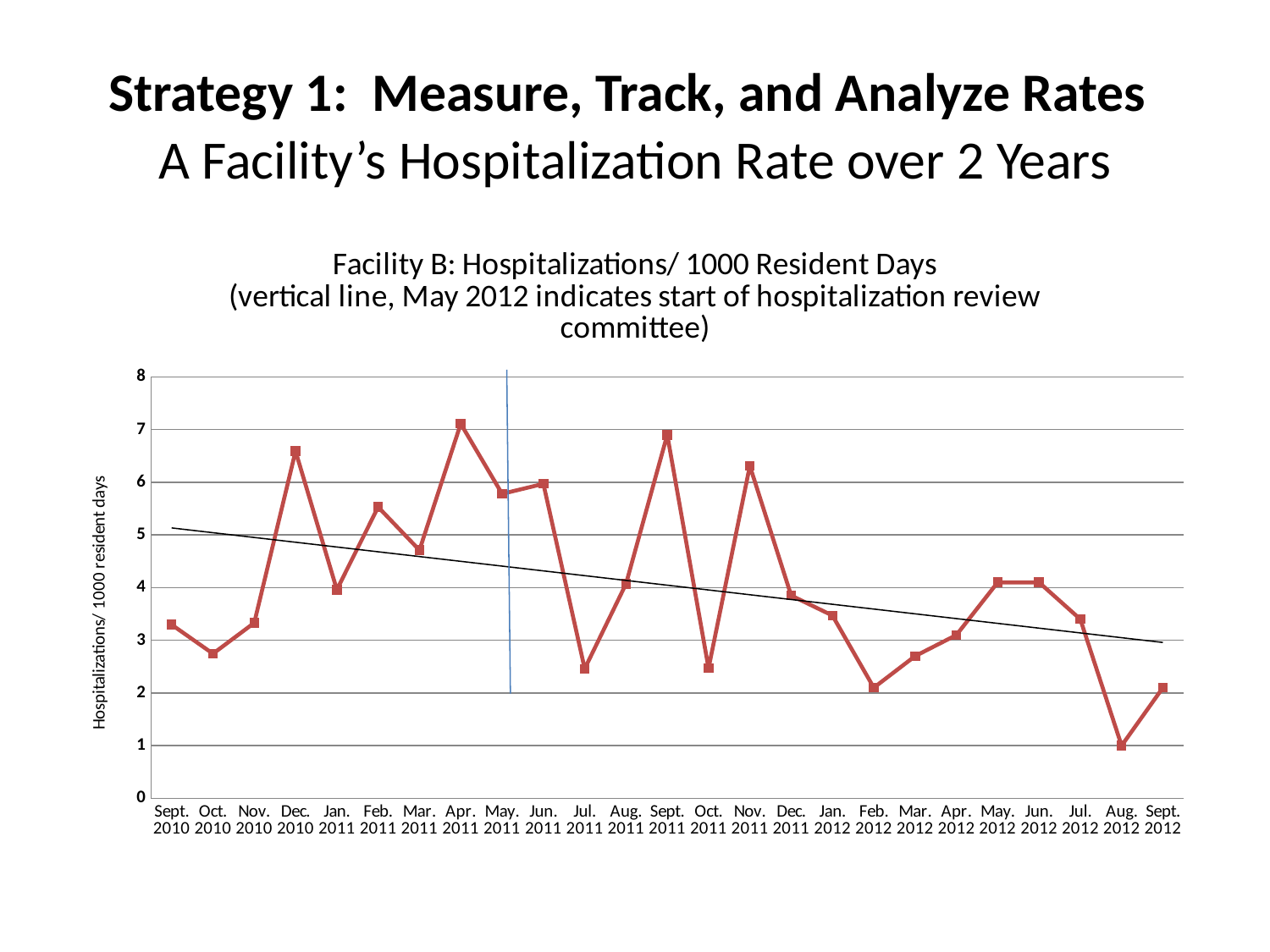
Which is higher, the value for Apr. 2011 or the value for May. 2011? Apr. 2011 What kind of chart is shown on the slide? line chart Which is higher, the value for Dec. 2010 or the value for Jan. 2011? Dec. 2010 Is the value for Jul. 2011 greater or less than 3? less How many monthly data points are plotted on the chart? 25 Is the value for Dec. 2010 greater or less than 6? greater What does the vertical line at May 2012 indicate, according to the chart title? start of hospitalization review committee What is the hospitalization rate per 1000 resident days for Aug. 2012? 1 Which month has the lowest hospitalization rate on the chart? Aug. 2012 According to the trend line, do hospitalization rates generally rise or fall from Sept. 2010 to Sept. 2012? fall Is the value for Feb. 2012 greater or less than 3? less